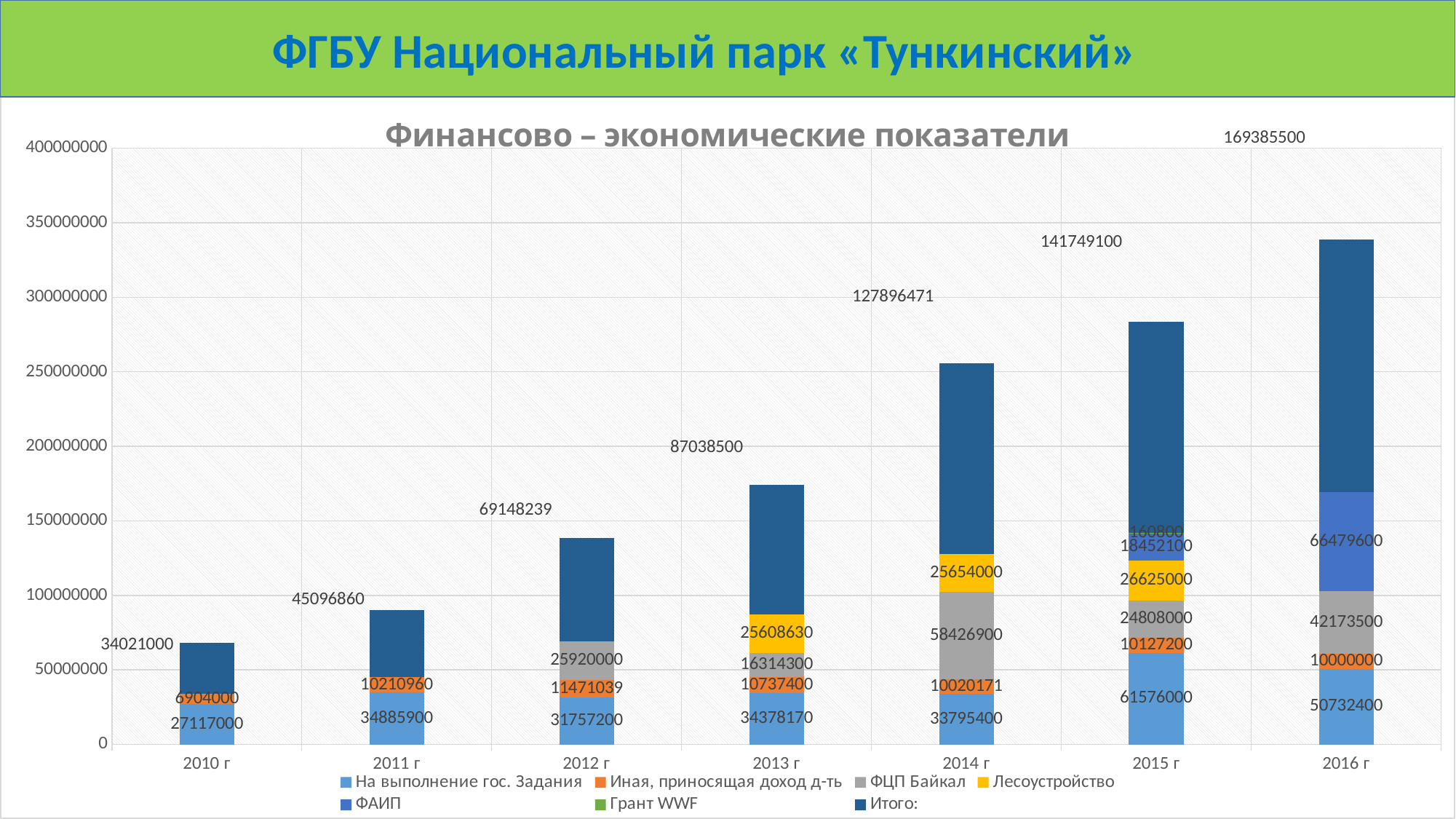
What kind of chart is shown on the slide? Stacked bar chart What is the value of «ФАИП» for 2016 г? 66479600 Which year has the lowest «Итого:» value? 2010 г What is the value of «ФЦП Байкал» for 2014 г? 58426900 How many series does the legend list? 7 What is the «Итого:» value shown for 2016 г? 169385500 Which year has the highest «Итого:» value? 2016 г What is the difference between the «На выполнение гос. Задания» values for 2015 г and 2014 г? 27780600 What is the value of «На выполнение гос. Задания» for 2010 г? 27117000 Which year has the larger «ФЦП Байкал» value, 2014 г or 2016 г? 2014 г Do the «Итого:» values rise or fall from 2010 г to 2016 г? Rise How many years are shown on the x axis? 7